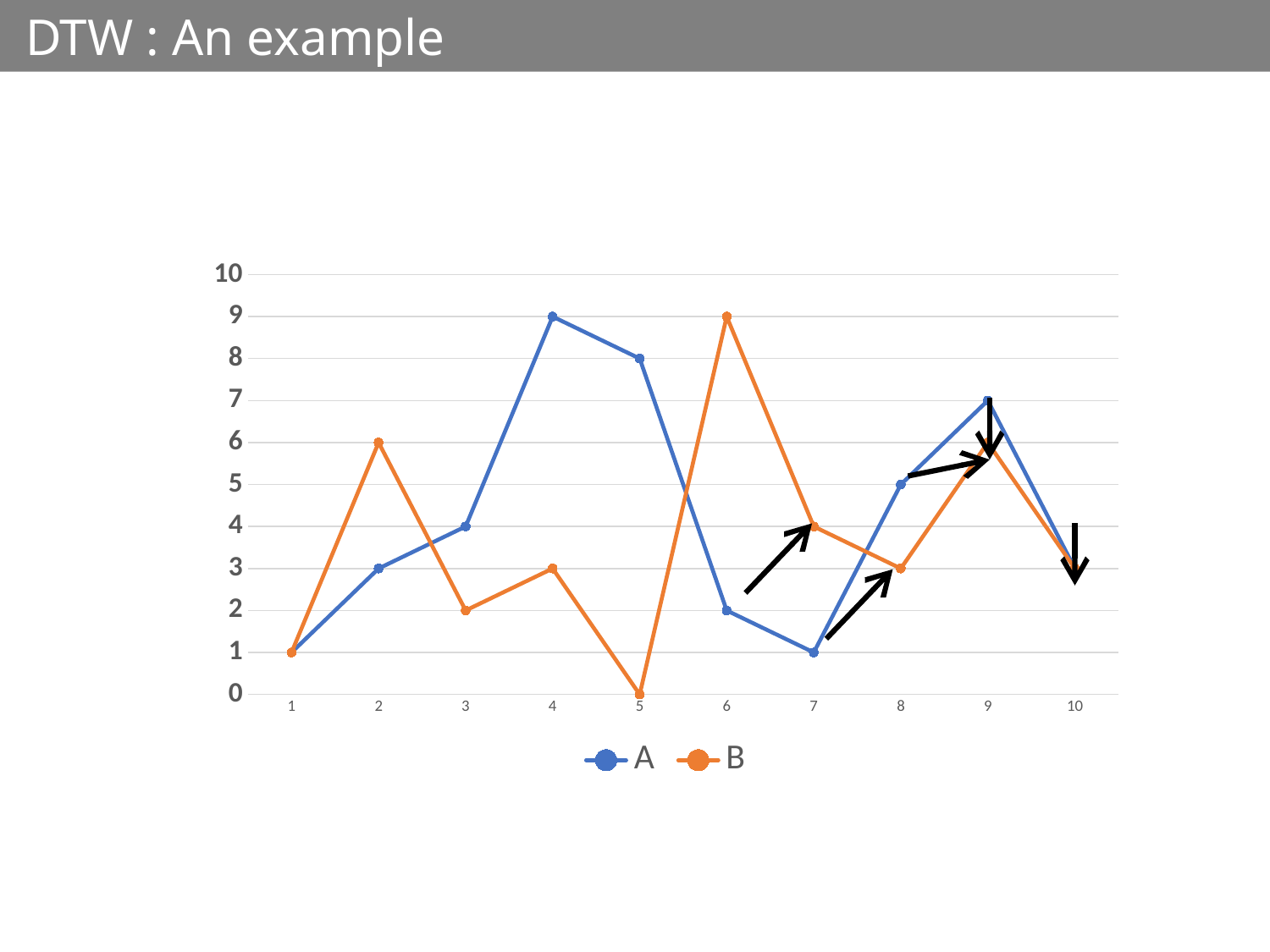
Which colour is used for series B in the legend? orange What is the value of series B at x = 5? 0 At which x value does series A reach its lowest value? 1 and 7 Does series A rise or fall from x = 5 to x = 7? fall What is the difference between series A and series B at x = 5? 8 At which x value does series B reach its highest value? 6 What is the value of series B at x = 6? 9 How many series does the legend list? 2 What kind of chart is shown on the slide? line chart How many points are plotted along the x axis for each series? 10 What is the value of series A at x = 4? 9 At x = 2, which series has the larger value, A or B? B